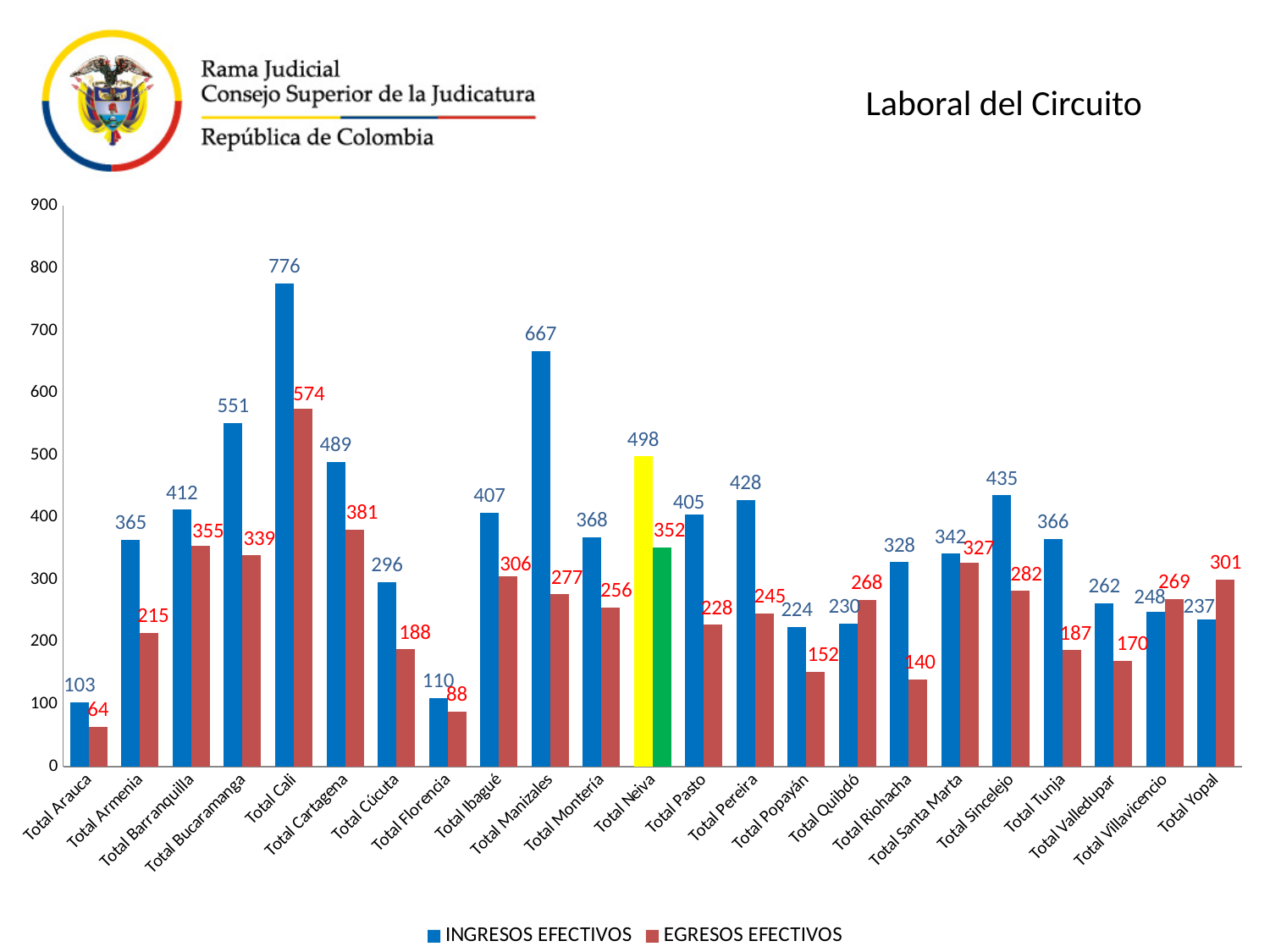
What is the difference between INGRESOS EFECTIVOS and EGRESOS EFECTIVOS for Total Manizales? 390 What is the INGRESOS EFECTIVOS value for Total Cali? 776 What is the EGRESOS EFECTIVOS value for Total Riohacha? 140 What is the EGRESOS EFECTIVOS value for Total Neiva? 352 Which category has the highest INGRESOS EFECTIVOS value? Total Cali How many categories are shown on the x axis? 23 Which category's INGRESOS EFECTIVOS bar is highlighted in yellow? Total Neiva For Total Yopal, which is larger: INGRESOS EFECTIVOS or EGRESOS EFECTIVOS? EGRESOS EFECTIVOS Is the INGRESOS EFECTIVOS value for Total Bucaramanga greater or less than 500? greater Which category has the lowest EGRESOS EFECTIVOS value? Total Arauca What kind of chart is shown on the slide? Bar chart How many series does the legend list? 2